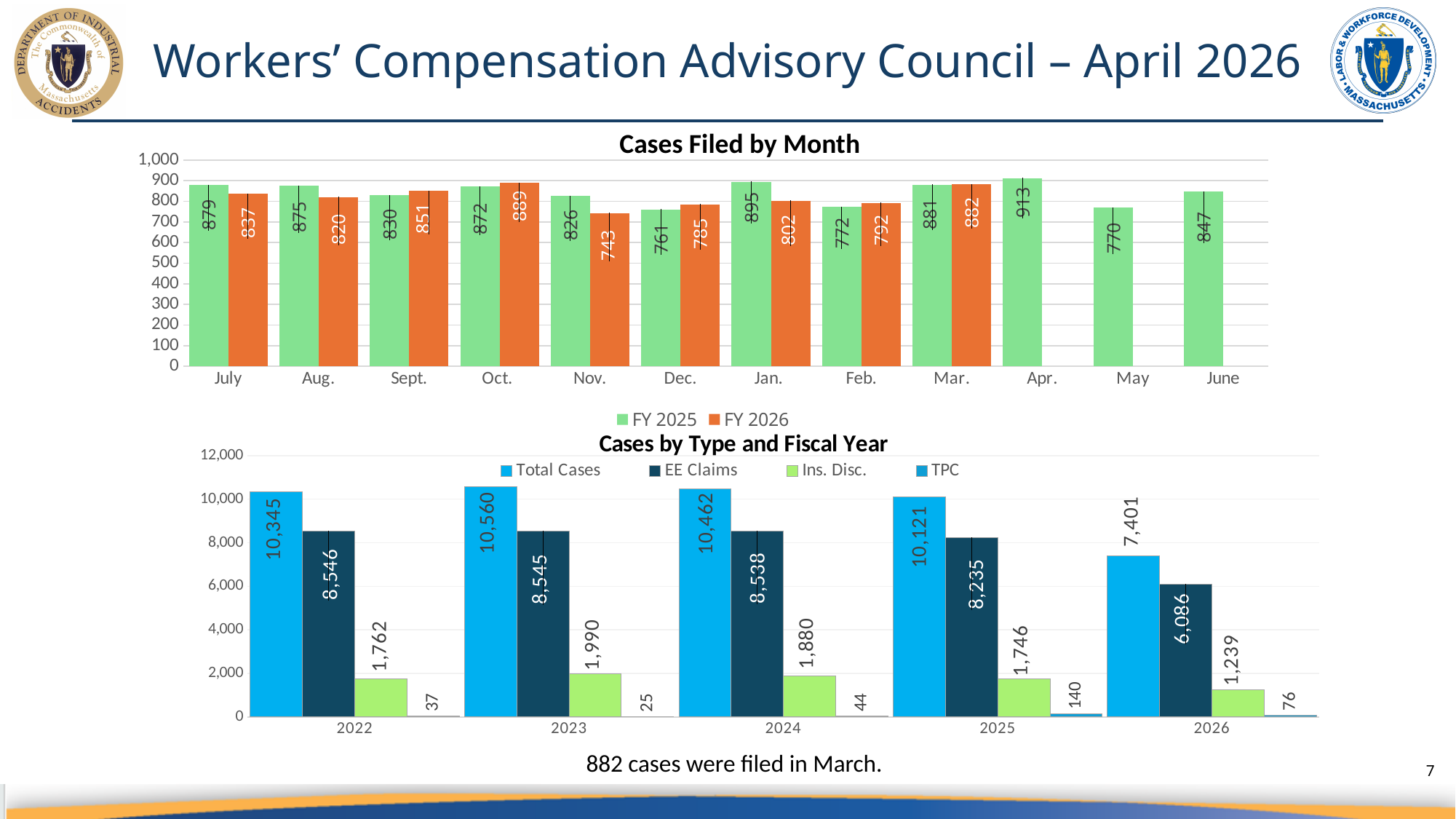
In the 'Cases Filed by Month' chart, which month has the highest FY 2025 value? Apr. In the 'Cases Filed by Month' chart, which month has the lowest FY 2026 value? Nov. In the 'Cases Filed by Month' chart, what is the difference between the FY 2025 and FY 2026 values for November? 83 In the 'Cases Filed by Month' chart, what is the FY 2025 value for November? 826 In the 'Cases Filed by Month' chart, what is the FY 2026 value for October? 889 In the 'Cases by Type and Fiscal Year' chart, what is the TPC value for 2025? 140 In the 'Cases by Type and Fiscal Year' chart, what is the difference between Total Cases and EE Claims for 2026? 1,315 In the 'Cases Filed by Month' chart, which is larger for September: the FY 2025 value or the FY 2026 value? FY 2026 In the 'Cases by Type and Fiscal Year' chart, what is the Total Cases value for 2024? 10,462 What kind of chart is 'Cases by Type and Fiscal Year'? Bar chart In the 'Cases by Type and Fiscal Year' chart, which year has the highest Ins. Disc. value? 2023 In the 'Cases Filed by Month' chart, how many series does the legend list? 2